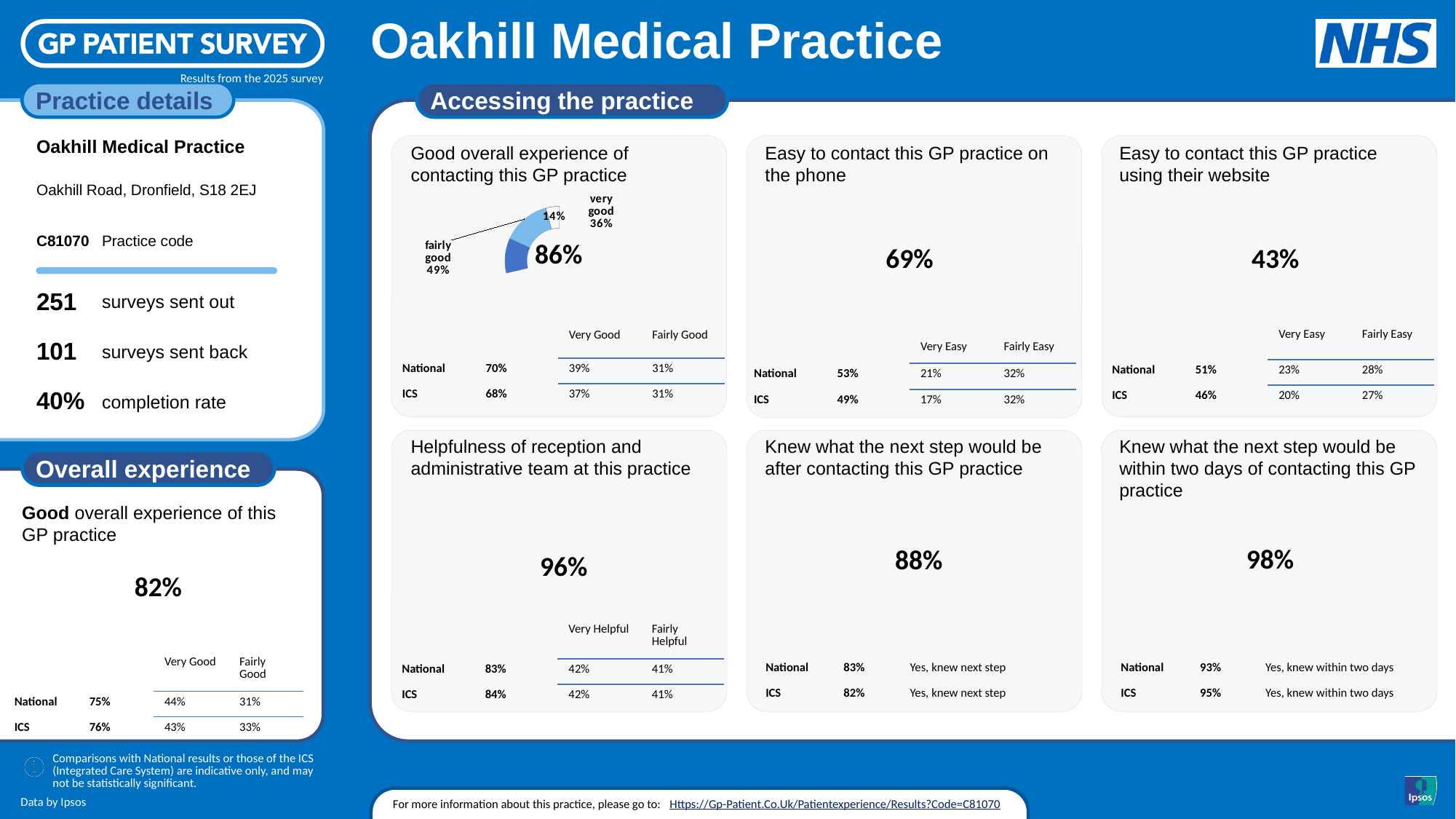
In the 'Good overall experience of contacting this GP practice' chart, is the 'very good' slice greater or less than 50%? less In the 'Good overall experience of contacting this GP practice' chart, which is larger: 'fairly good' or 'very good'? fairly good What kind of chart is used in the 'Good overall experience of contacting this GP practice' panel? Doughnut (pie) chart In the 'Good overall experience of contacting this GP practice' chart, what is the difference between the 'fairly good' and 'very good' percentages? 13 percentage points Which labelled slice is the largest in the 'Good overall experience of contacting this GP practice' chart? fairly good How many slices with percentage labels are shown in the 'Good overall experience of contacting this GP practice' chart? 3 What is the large percentage shown in the centre of the 'Good overall experience of contacting this GP practice' chart? 86% In the 'Good overall experience of contacting this GP practice' chart, what is the value of the smallest slice? 14% In the 'Good overall experience of contacting this GP practice' chart, what percentage is labelled 'fairly good'? 49% Below the 'Good overall experience of contacting this GP practice' chart, what is the National overall percentage shown for comparison? 70% What is the title of the panel containing the doughnut chart on the slide? Good overall experience of contacting this GP practice In the 'Good overall experience of contacting this GP practice' chart, what percentage is labelled 'very good'? 36%